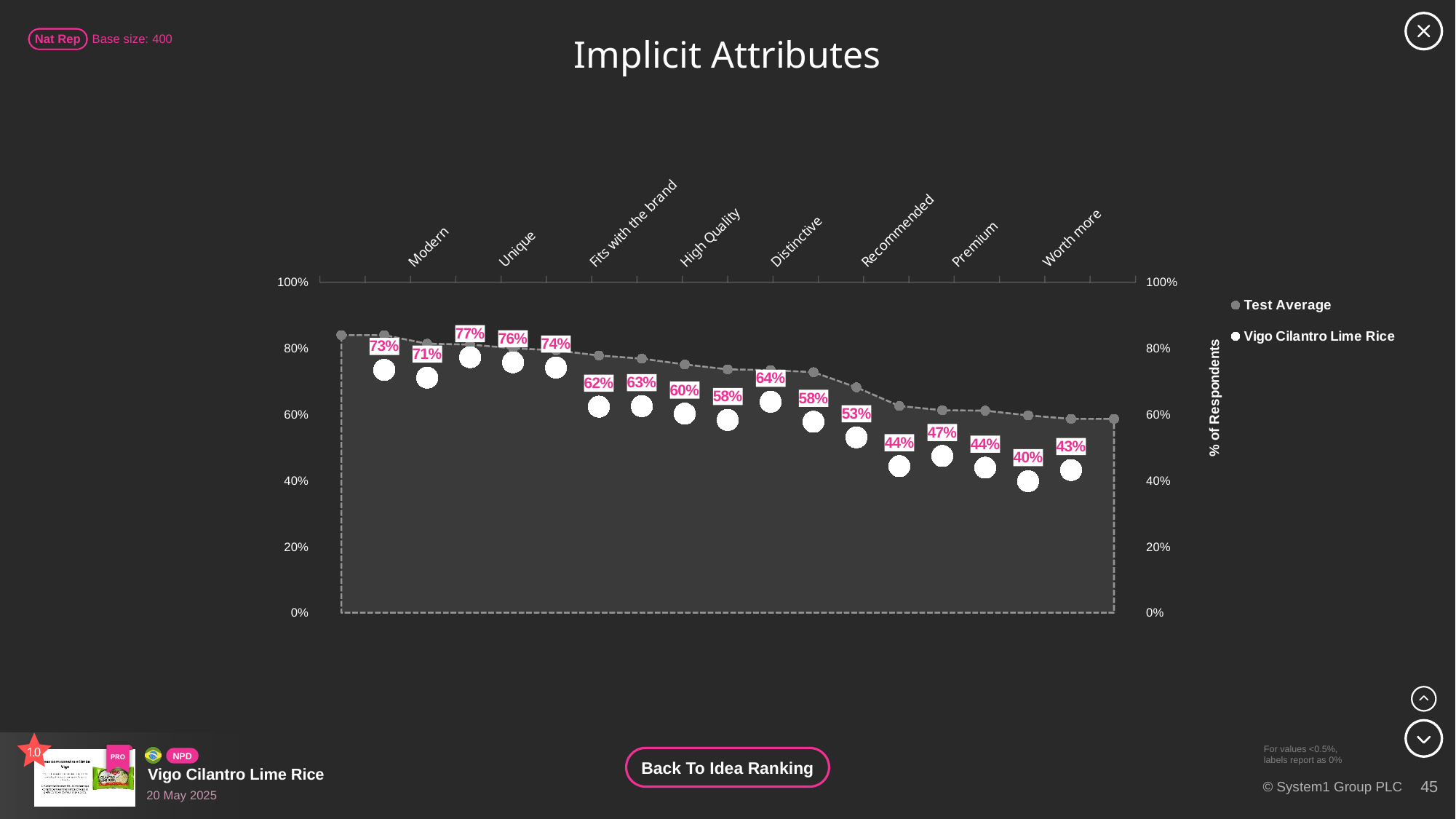
What is the title of the chart? Implicit Attributes What kind of chart is shown on the slide? Line chart Is the leftmost Test Average point greater or less than 80%? greater How many series does the legend list? 2 What is the value of the leftmost labelled point for Vigo Cilantro Lime Rice? 73% What is the value of the rightmost labelled point for Vigo Cilantro Lime Rice? 43% What are the two series named in the legend? Test Average and Vigo Cilantro Lime Rice How many labelled data points are there for Vigo Cilantro Lime Rice? 17 What is the lowest labelled value for Vigo Cilantro Lime Rice? 40% What is the difference between the highest and lowest labelled values for Vigo Cilantro Lime Rice? 37 percentage points What is the highest labelled value for Vigo Cilantro Lime Rice? 77% Do the Vigo Cilantro Lime Rice values generally rise or fall from left to right? Fall